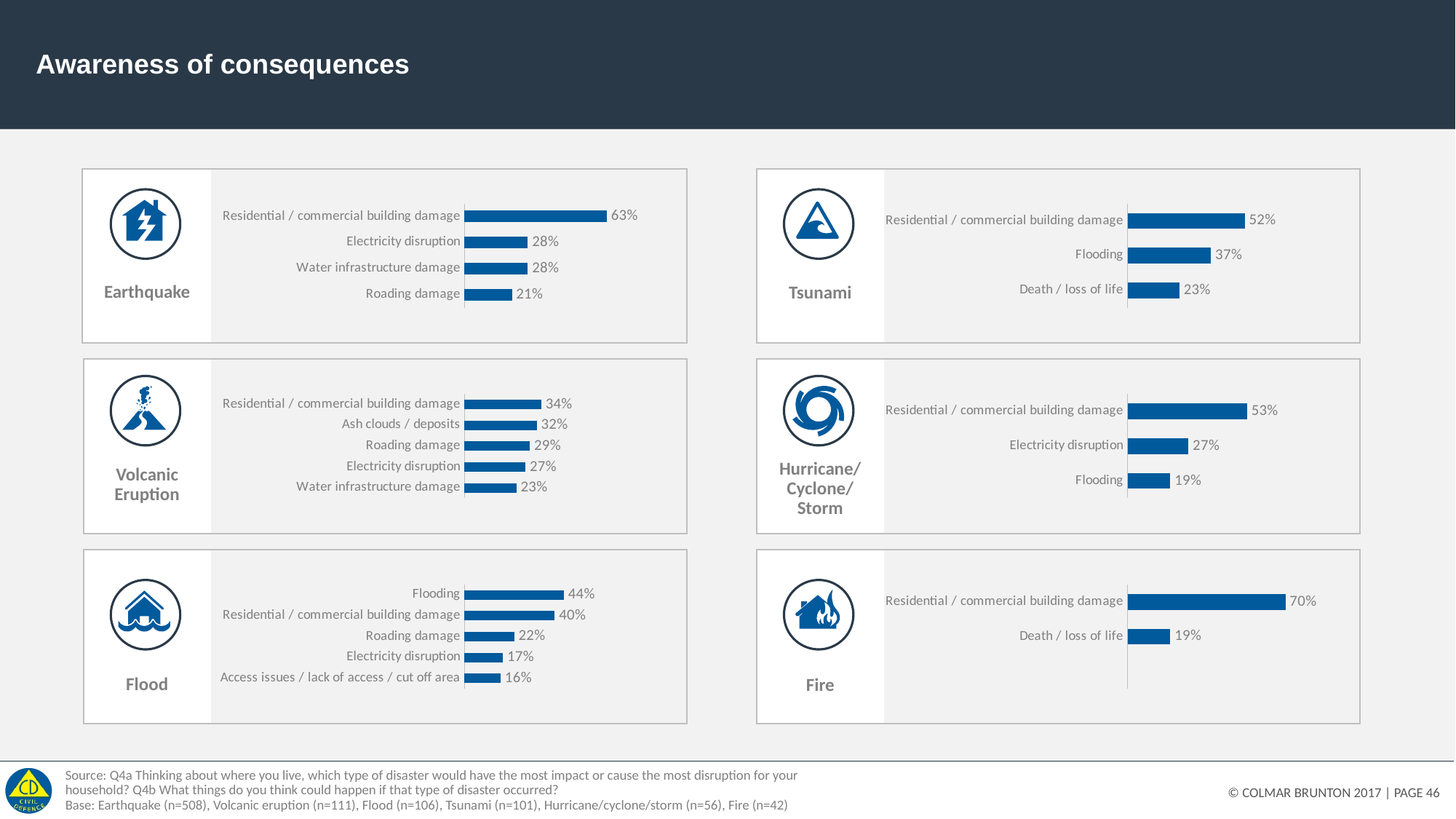
In the Hurricane/Cyclone/Storm chart, which is larger: Electricity disruption or Flooding? Electricity disruption How many consequences are listed in the Volcanic Eruption chart? 5 In the Flood chart, which consequence has the lowest percentage? Access issues / lack of access / cut off area In the Tsunami chart, what percentage is shown for Flooding? 37% In the Fire chart, what is the difference between Residential / commercial building damage and Death / loss of life? 51 percentage points In the Earthquake chart, what is the difference between Residential / commercial building damage and Roading damage? 42 percentage points In the Volcanic Eruption chart, which consequence has the highest percentage? Residential / commercial building damage In the Earthquake chart, what percentage is shown for Residential / commercial building damage? 63% In the Flood chart, what percentage is shown for Electricity disruption? 17% What type of chart is used in the Earthquake panel? Bar chart What is the title of the slide? Awareness of consequences How many consequences are listed in the Fire chart? 2